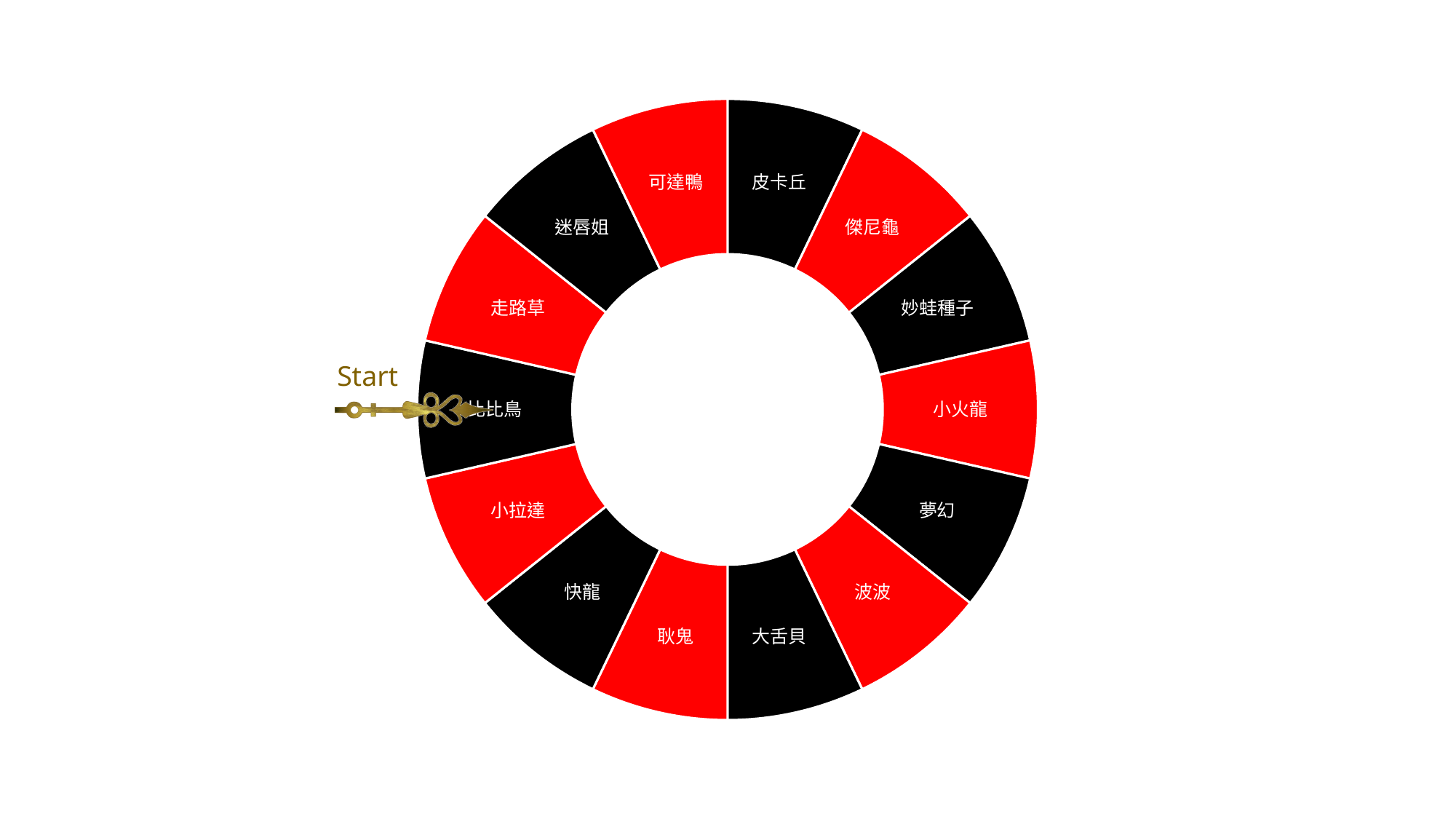
What two colours are used for the segments of the wheel? Red and black Which segment lies between 小火龍 and 波波? 夢幻 Which segment is at the bottom of the wheel next to 耿鬼, on its right? 大舌貝 Which segment is directly clockwise from 皮卡丘? 傑尼龜 Which segment is directly counter-clockwise from 皮卡丘? 可達鴨 What kind of chart is shown on the slide? Doughnut chart Which segment does the 'Start' pointer on the left point to? 比比鳥 How many segments does the doughnut chart have? 14